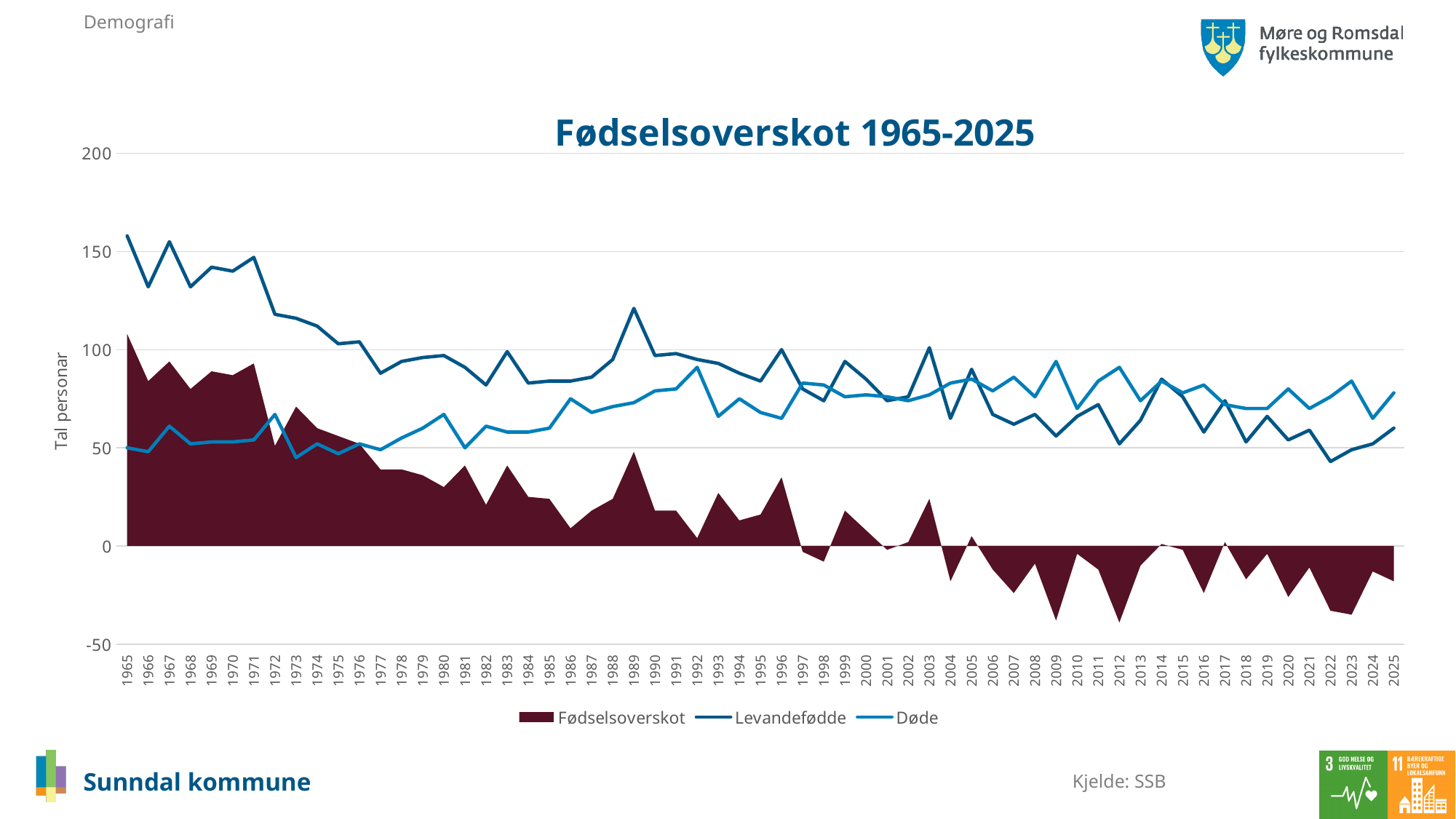
How many series does the legend list? 3 What is the label on the vertical axis? Tal personar Does the Levandefødde series generally rise or fall from 1965 to 2025? Fall Is the value for Levandefødde in 1965 greater or less than 150? greater In 1965, which is larger: Levandefødde or Døde? Levandefødde Is the value for Levandefødde in 2022 greater or less than 50? less What is the title of the chart? Fødselsoverskot 1965-2025 How many years are plotted along the x axis? 61 What kind of chart is shown on the slide? A combined area and line chart In which year is Levandefødde at its highest? 1965 Is the value for Fødselsoverskot in 2012 greater or less than 0? less